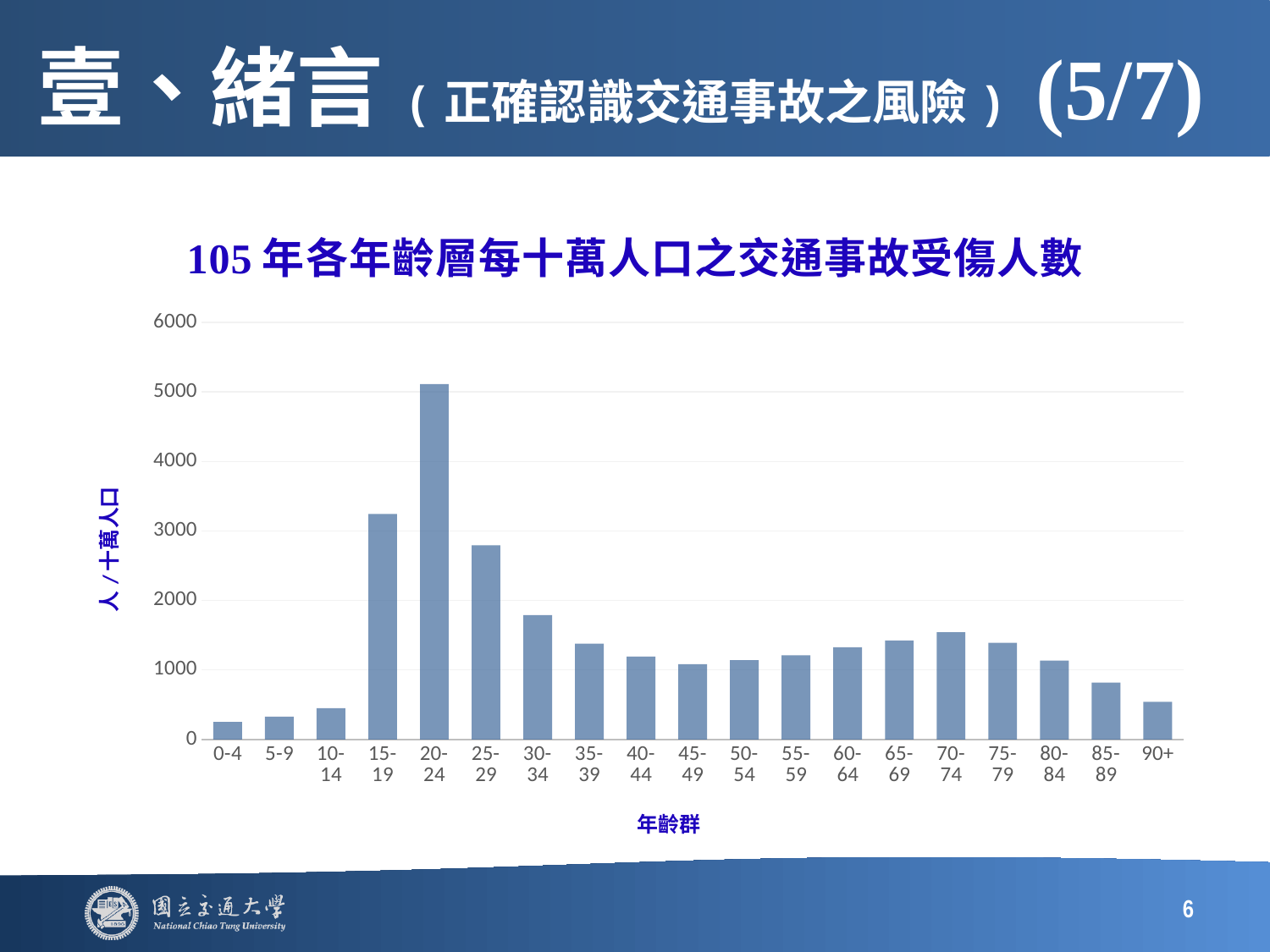
Which age group has a higher value, 70-74 or 90+? 70-74 What is the label of the x axis of the chart? 年齡群 Is the value for the 85-89 age group greater or less than 1000? less How many age groups are shown on the x axis of the chart? 19 Is the value for the 15-19 age group greater or less than 3000? greater Do the values rise or fall from the 0-4 age group to the 20-24 age group? rise Which age group has a higher value, 25-29 or 30-34? 25-29 Which age group has the highest number of traffic accident injuries per 100,000 population? 20-24 What kind of chart is shown on the slide? bar chart Which age group has the lowest number of traffic accident injuries per 100,000 population? 0-4 Is the value for the 20-24 age group greater or less than 5000? greater